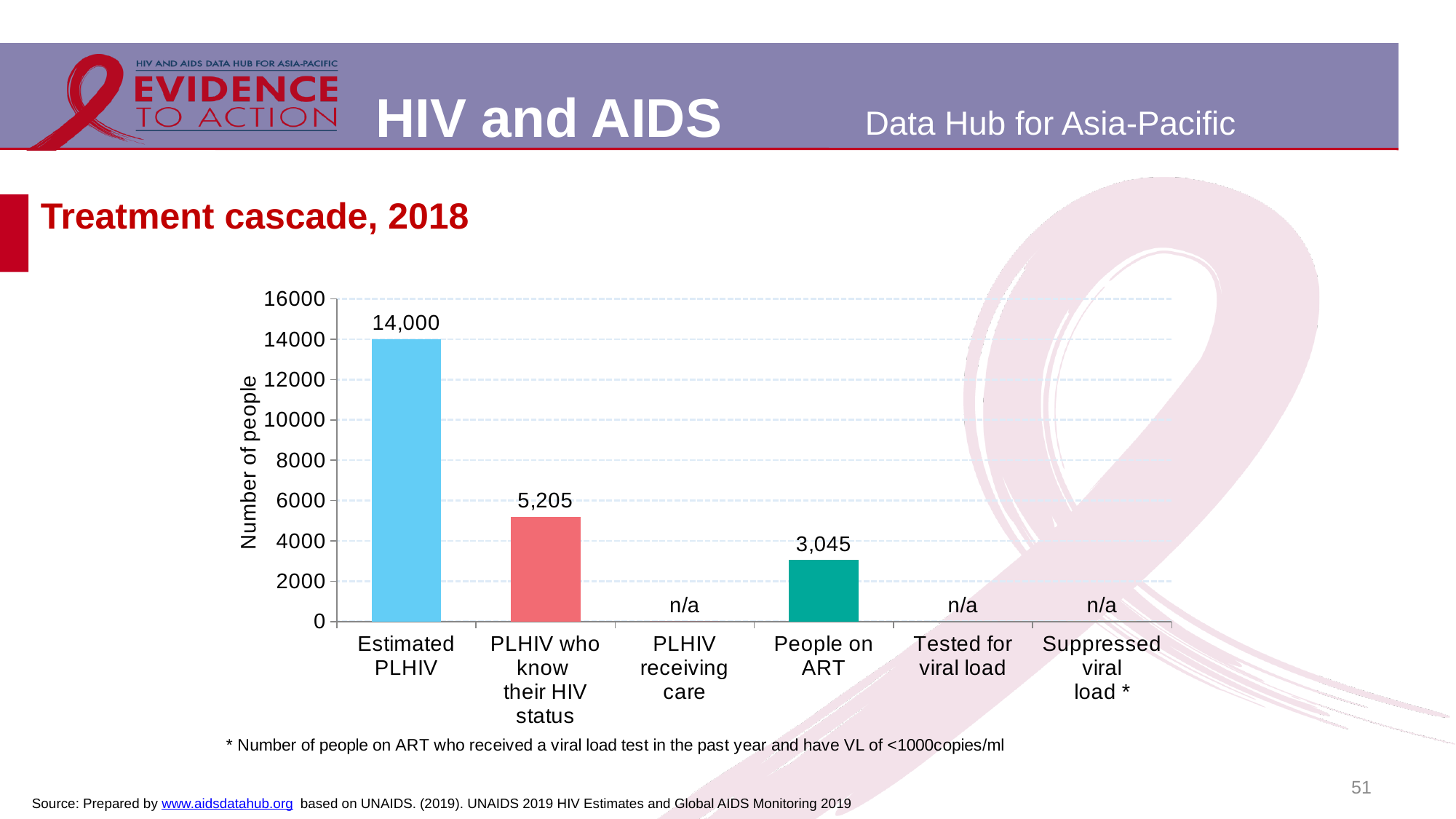
Which is larger, PLHIV who know their HIV status or People on ART? PLHIV who know their HIV status Which category has the highest value? Estimated PLHIV What is the value for Estimated PLHIV? 14,000 Among the categories with plotted values, which has the lowest value? People on ART What is the value for PLHIV who know their HIV status? 5,205 How many categories are shown on the x axis? 6 What is the difference between Estimated PLHIV and PLHIV who know their HIV status? 8,795 What is the value for People on ART? 3,045 What is the difference between PLHIV who know their HIV status and People on ART? 2,160 What is the y-axis label of the chart? Number of people What is shown for PLHIV receiving care? n/a What kind of chart is this? Bar chart